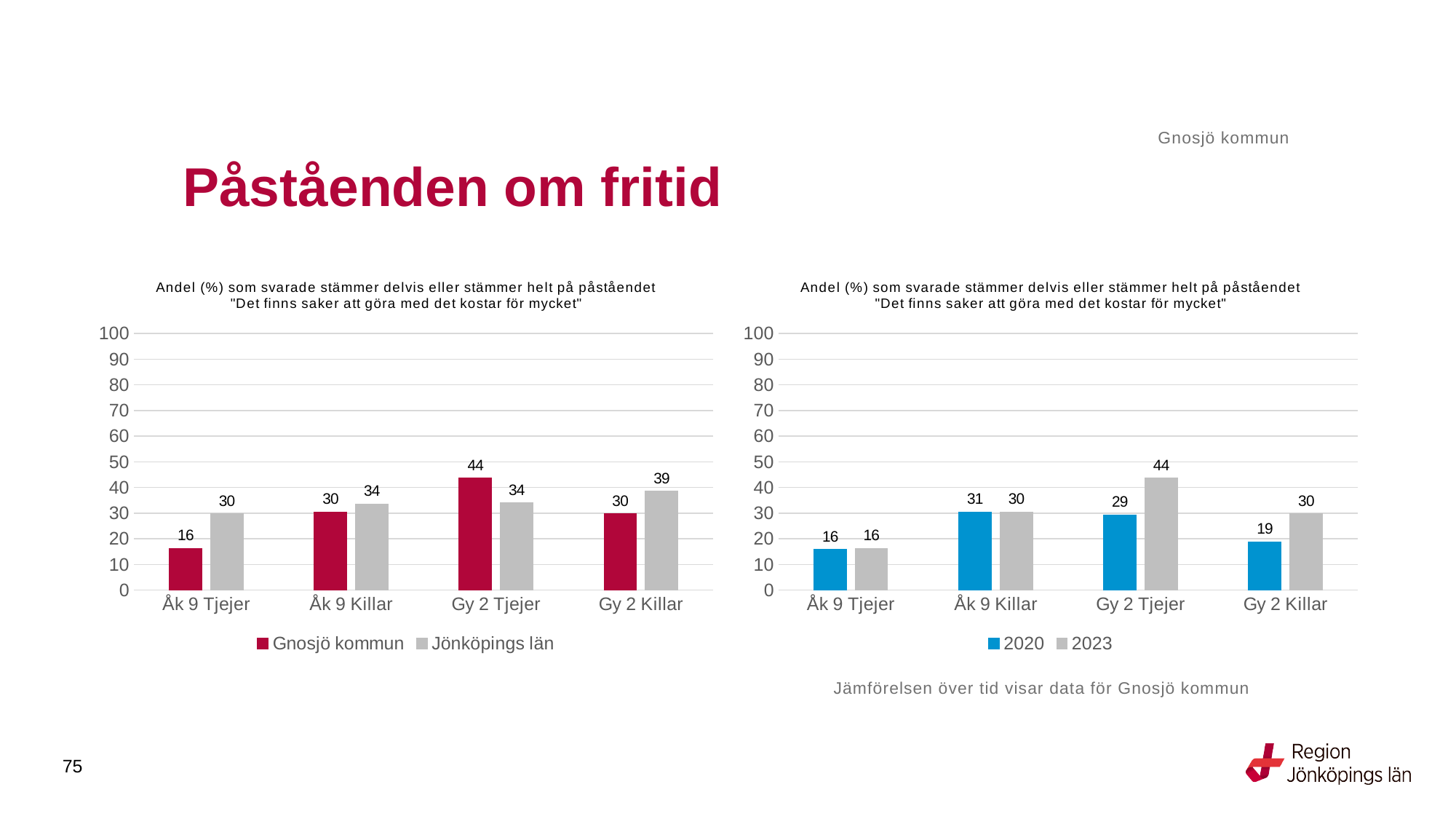
In the left chart, what is the value for Jönköpings län for Gy 2 Killar? 39 In the left chart, which category has the highest value for Gnosjö kommun? Gy 2 Tjejer How many series does the legend of the right chart list? 2 In the right chart, what is the value for 2023 for Gy 2 Tjejer? 44 In the right chart, which category has the lowest value for 2020? Åk 9 Tjejer In the right chart, what is the difference between 2023 and 2020 for Gy 2 Tjejer? 15 What kind of chart is the left chart? Bar chart In the left chart, which is larger for Gy 2 Tjejer: Gnosjö kommun or Jönköpings län? Gnosjö kommun In the left chart, which category has the lowest value for Jönköpings län? Åk 9 Tjejer In the right chart, what is the value for 2020 for Gy 2 Killar? 19 In the left chart, what is the difference between Gnosjö kommun and Jönköpings län for Åk 9 Tjejer? 14 In the left chart, what is the value for Gnosjö kommun for Åk 9 Tjejer? 16